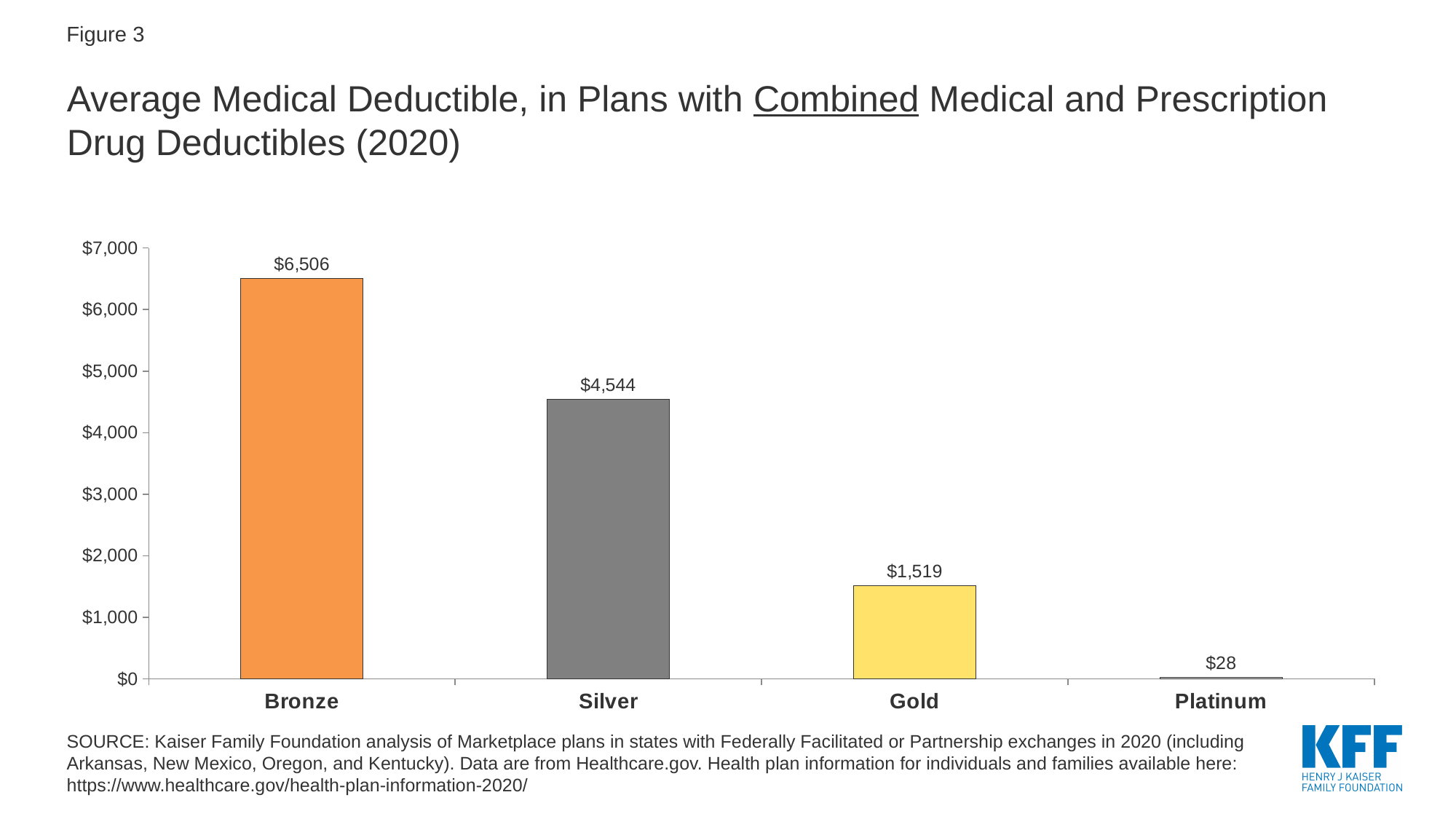
What is the difference between the Gold and Platinum average medical deductibles? $1,491 Which plan type has the highest average medical deductible? Bronze What is the difference between the Bronze and Silver average medical deductibles? $1,962 What is the average medical deductible for Platinum plans? $28 What is the average medical deductible for Silver plans? $4,544 What is the average medical deductible for Gold plans? $1,519 Which is larger, the average medical deductible for Silver or for Gold? Silver Do the values rise or fall moving from Bronze to Platinum along the x axis? Fall How many plan types are shown on the chart? 4 Which plan type has the lowest average medical deductible? Platinum What is the average medical deductible for Bronze plans? $6,506 What kind of chart is shown on the slide? Bar chart